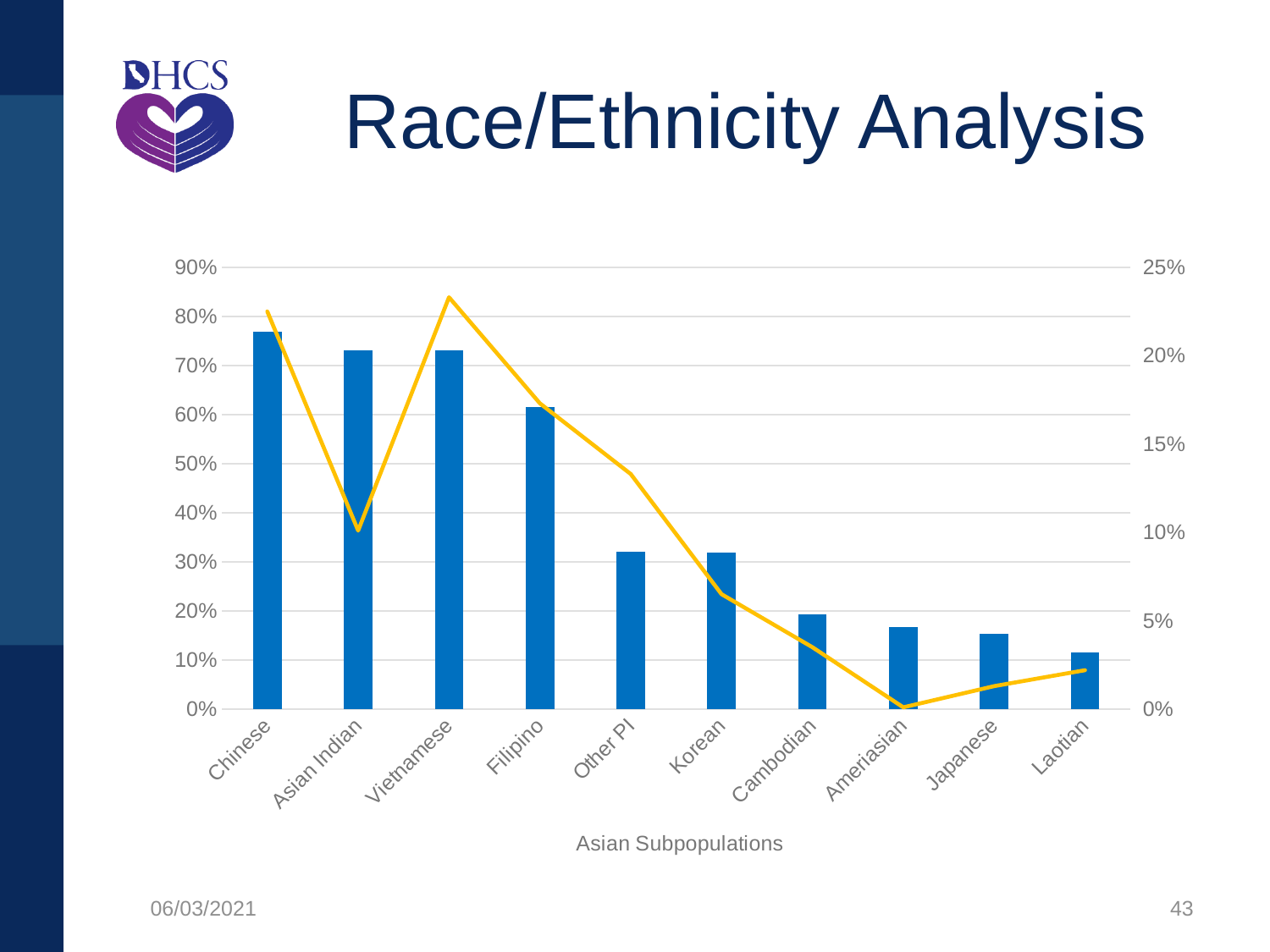
Is the bar value for Chinese greater or less than 70%? greater Do the bar values generally rise or fall moving from left to right along the x axis? fall Which has the taller bar, Cambodian or Laotian? Cambodian At which Asian subpopulation does the yellow line reach its lowest point? Ameriasian Is the bar value for Laotian greater or less than 20%? less How many Asian subpopulation categories are shown on the x axis of the chart? 10 Which Asian subpopulation has the tallest bar in the chart? Chinese Which has the taller bar, Filipino or Other PI? Filipino Is the bar value for Filipino greater or less than 70%? less Which Asian subpopulation has the shortest bar in the chart? Laotian What is the title of the x axis of the chart? Asian Subpopulations